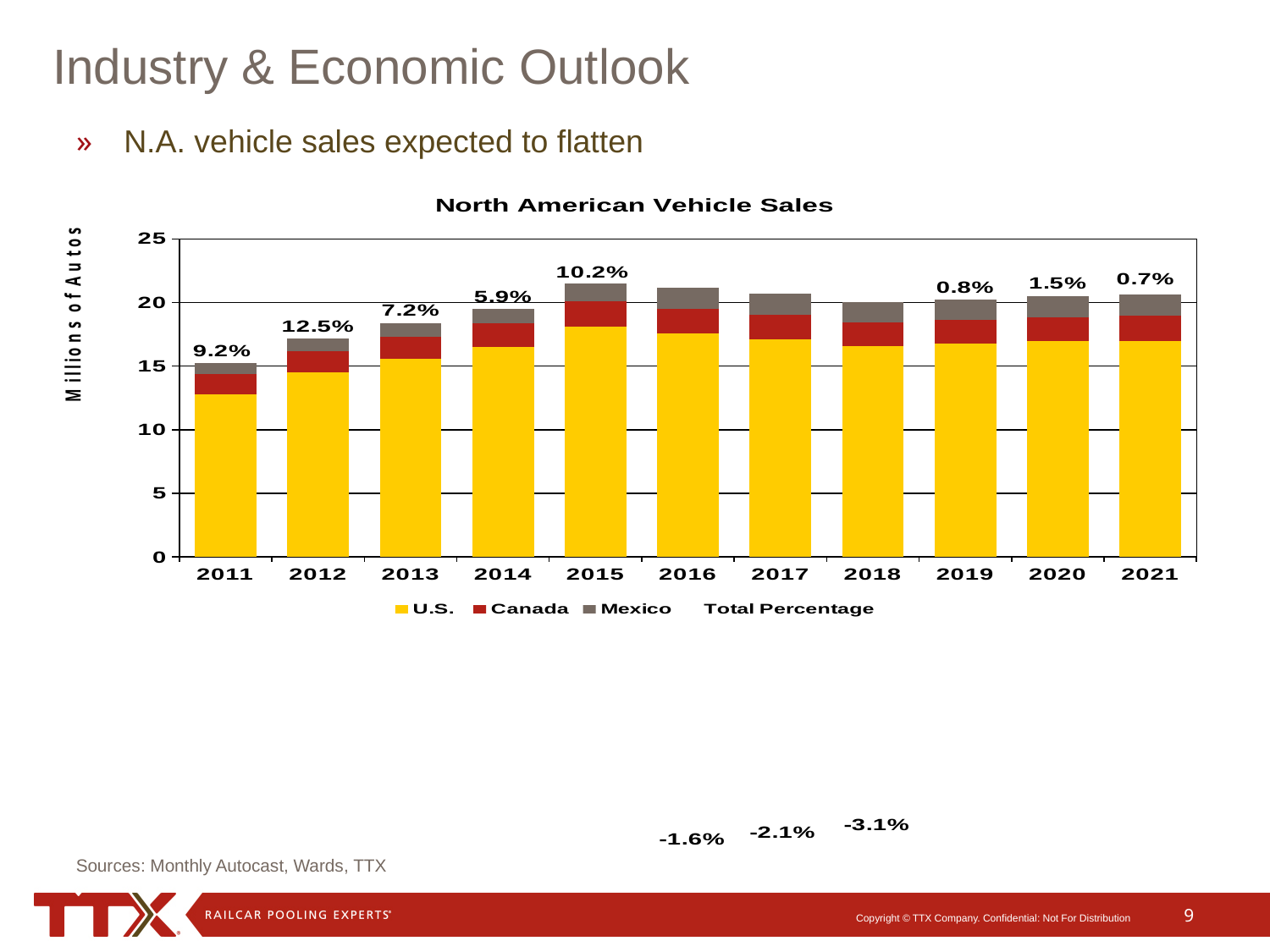
What is the Total Percentage label shown for 2021? 0.7% What is the difference between the Total Percentage labels for 2012 and 2011? 3.3 percentage points What is the Total Percentage label shown for 2015? 10.2% How many years are shown on the x axis of the North American Vehicle Sales chart? 11 Which year has the highest Total Percentage label on the chart? 2012 How many entries does the legend of the chart list? 4 What kind of chart is shown on the slide? Stacked bar chart Which year has a taller total stacked bar, 2011 or 2015? 2015 Is the total height of the stacked bar for 2011 greater or less than 20 million autos? less What is the label on the vertical axis of the chart? Millions of Autos Is the total height of the stacked bar for 2015 greater or less than 20 million autos? greater What is the Total Percentage label shown for 2012? 12.5%